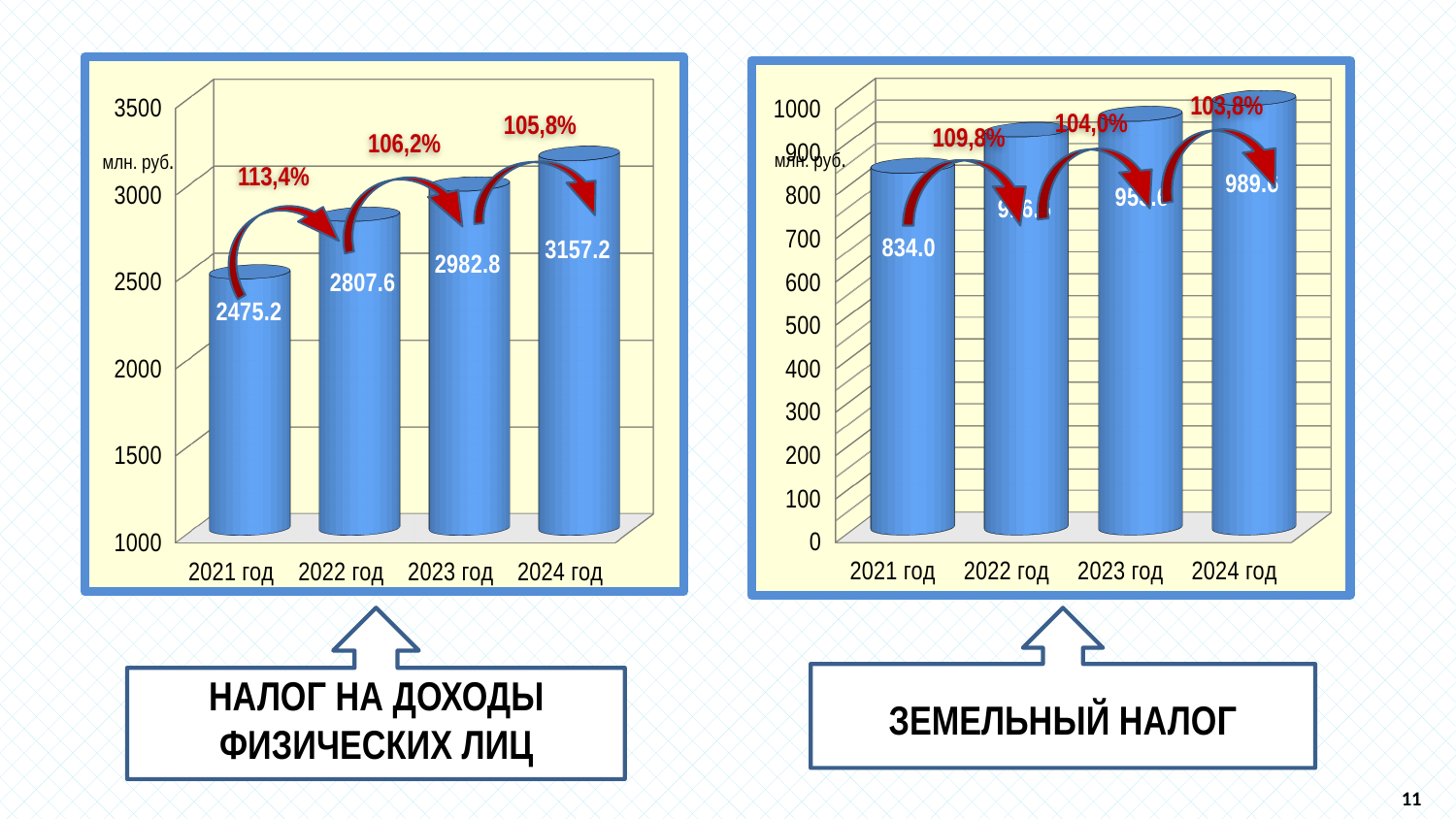
On the right chart (ЗЕМЕЛЬНЫЙ НАЛОГ), what is the value for 2021 год? 834.0 On the left chart (НАЛОГ НА ДОХОДЫ ФИЗИЧЕСКИХ ЛИЦ), what is the difference between the 2023 год and 2022 год values? 175.2 On the right chart (ЗЕМЕЛЬНЫЙ НАЛОГ), what is the value for 2024 год? 989.6 On the left chart (НАЛОГ НА ДОХОДЫ ФИЗИЧЕСКИХ ЛИЦ), what is the value for 2021 год? 2475.2 What kind of chart is the right chart (ЗЕМЕЛЬНЫЙ НАЛОГ)? bar chart On the left chart (НАЛОГ НА ДОХОДЫ ФИЗИЧЕСКИХ ЛИЦ), do the values rise or fall from 2021 год to 2024 год? rise On the right chart (ЗЕМЕЛЬНЫЙ НАЛОГ), what growth percentage is shown between 2023 год and 2024 год? 103,8% On the right chart (ЗЕМЕЛЬНЫЙ НАЛОГ), how many years are plotted? 4 On the right chart (ЗЕМЕЛЬНЫЙ НАЛОГ), what is the difference between the 2024 год and 2021 год values? 155.6 On the left chart (НАЛОГ НА ДОХОДЫ ФИЗИЧЕСКИХ ЛИЦ), what growth percentage is shown between 2021 год and 2022 год? 113,4% On the left chart (НАЛОГ НА ДОХОДЫ ФИЗИЧЕСКИХ ЛИЦ), which year has the lowest value? 2021 год On the left chart (НАЛОГ НА ДОХОДЫ ФИЗИЧЕСКИХ ЛИЦ), what is the value for 2024 год? 3157.2